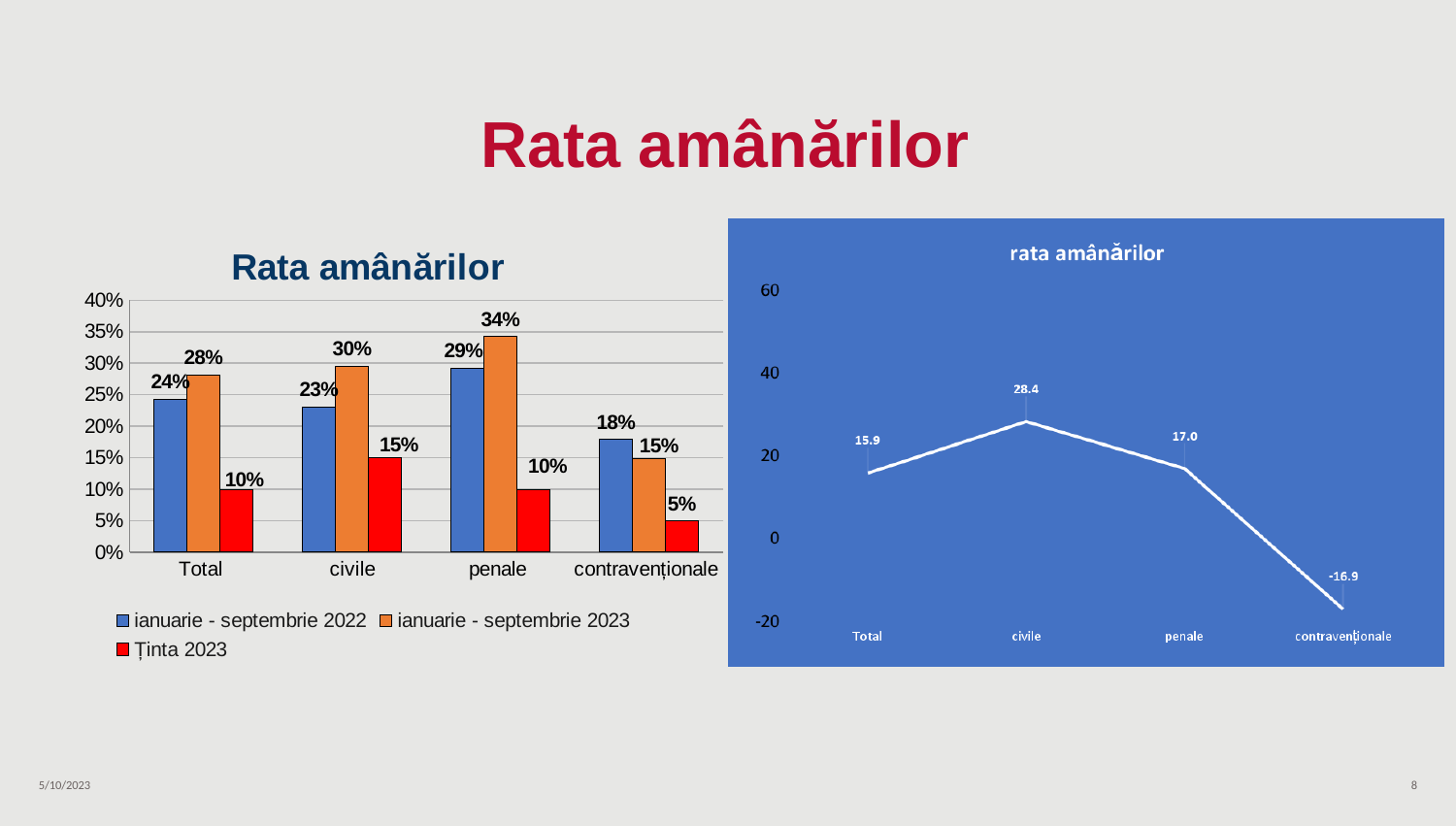
In the right line chart 'rata amânărilor', what is the value for 'civile'? 28.4 In the right line chart 'rata amânărilor', which category has the lowest value? contravenționale In the right line chart 'rata amânărilor', what is the value for 'contravenționale'? -16.9 In the left bar chart 'Rata amânărilor', for 'contravenționale', which is larger: the 'ianuarie - septembrie 2022' value or the 'ianuarie - septembrie 2023' value? ianuarie - septembrie 2022 In the left bar chart 'Rata amânărilor', which category has the lowest value in the series 'ianuarie - septembrie 2023'? contravenționale In the left bar chart 'Rata amânărilor', what is the value for 'penale' in the series 'ianuarie - septembrie 2023'? 34% How many data points are plotted in the right line chart 'rata amânărilor'? 4 In the left bar chart 'Rata amânărilor', which category has the highest value in the series 'ianuarie - septembrie 2022'? penale What kind of chart is the left chart titled 'Rata amânărilor'? bar chart In the left bar chart 'Rata amânărilor', what is the difference between the 'ianuarie - septembrie 2023' value and the 'ianuarie - septembrie 2022' value for 'civile'? 7% How many series does the legend of the left bar chart 'Rata amânărilor' list? 3 In the left bar chart 'Rata amânărilor', what is the 'Ținta 2023' value for 'contravenționale'? 5%